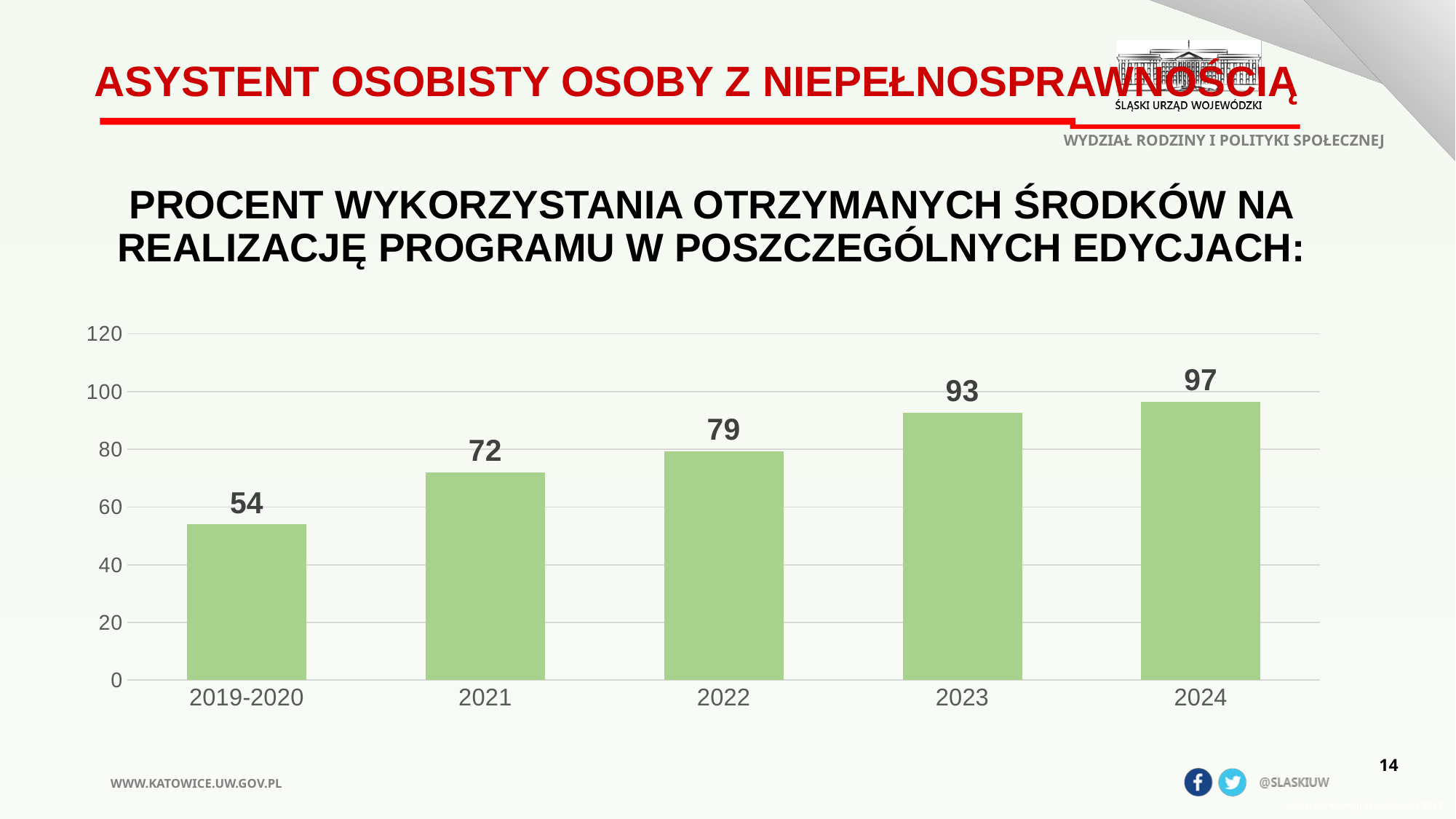
What is the value for 2024? 97 Which category has the highest value? 2024 Is the value for 2023 greater or less than 80? greater Which is larger, the value for 2021 or the value for 2022? 2022 How many categories are shown on the x axis? 5 Which category has the lowest value? 2019-2020 What is the value for 2022? 79 What is the difference between the values for 2024 and 2019-2020? 43 Do the values rise or fall from 2019-2020 to 2024? rise What kind of chart is shown on the slide? bar chart What is the difference between the values for 2023 and 2021? 21 What is the value for 2019-2020? 54